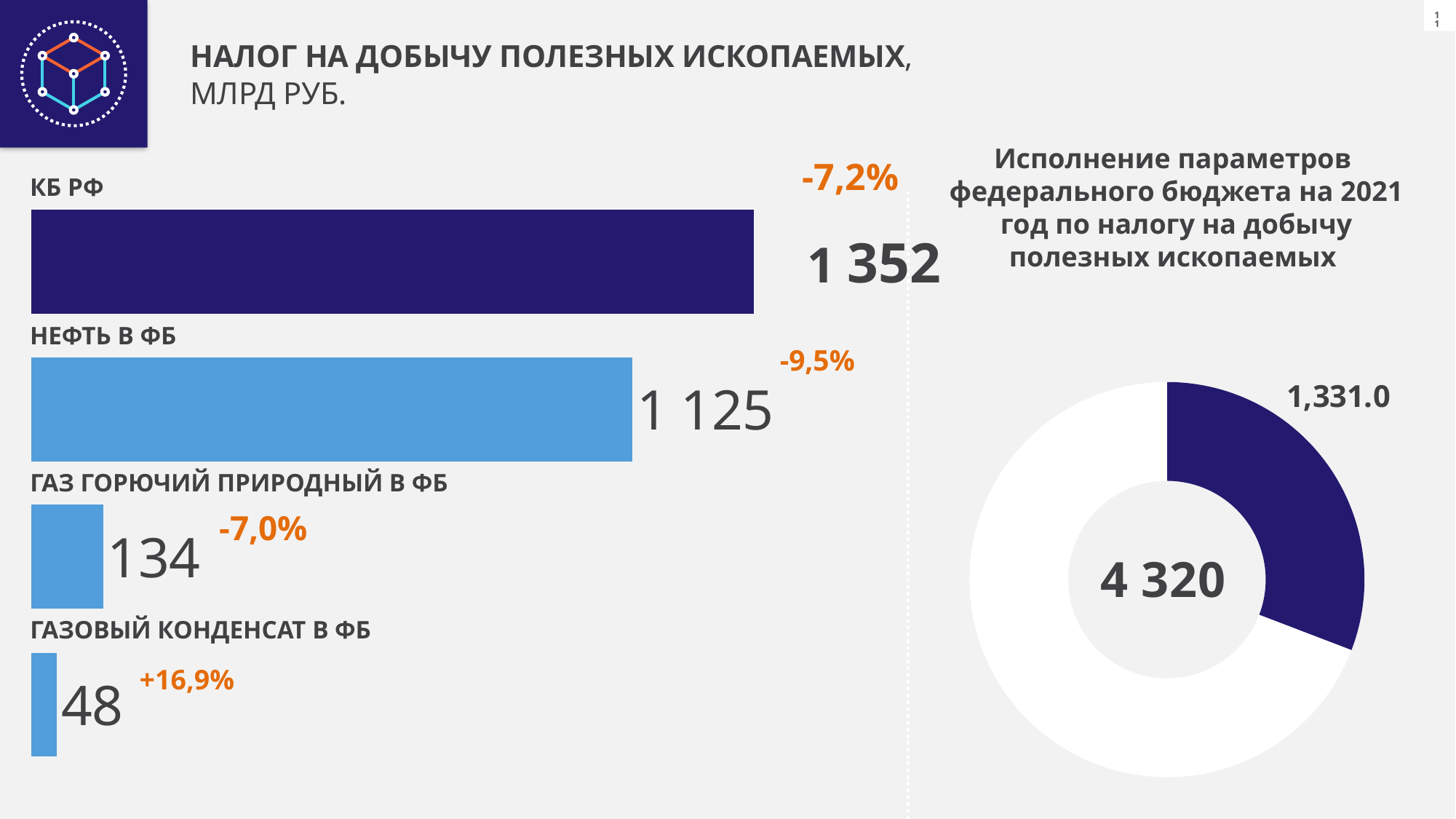
How many categories are shown in the bar chart on the left? 4 In the bar chart on the left, what is the value for НЕФТЬ В ФБ? 1 125 In the bar chart on the left, which category has the highest value? КБ РФ In the donut chart on the right, what value is printed on the filled segment? 1,331.0 In the bar chart on the left, what is the difference between the values for КБ РФ and НЕФТЬ В ФБ? 227 In the bar chart on the left, what is the value for ГАЗ ГОРЮЧИЙ ПРИРОДНЫЙ В ФБ? 134 In the bar chart on the left, which category has the lowest value? ГАЗОВЫЙ КОНДЕНСАТ В ФБ What type of chart is shown on the right side of the slide? Donut chart In the bar chart on the left, what percentage change is shown next to ГАЗОВЫЙ КОНДЕНСАТ В ФБ? +16,9% In the bar chart on the left, which is larger: the value for ГАЗ ГОРЮЧИЙ ПРИРОДНЫЙ В ФБ or ГАЗОВЫЙ КОНДЕНСАТ В ФБ? ГАЗ ГОРЮЧИЙ ПРИРОДНЫЙ В ФБ In the bar chart on the left, what is the value for КБ РФ? 1 352 In the bar chart on the left, what is the value for ГАЗОВЫЙ КОНДЕНСАТ В ФБ? 48